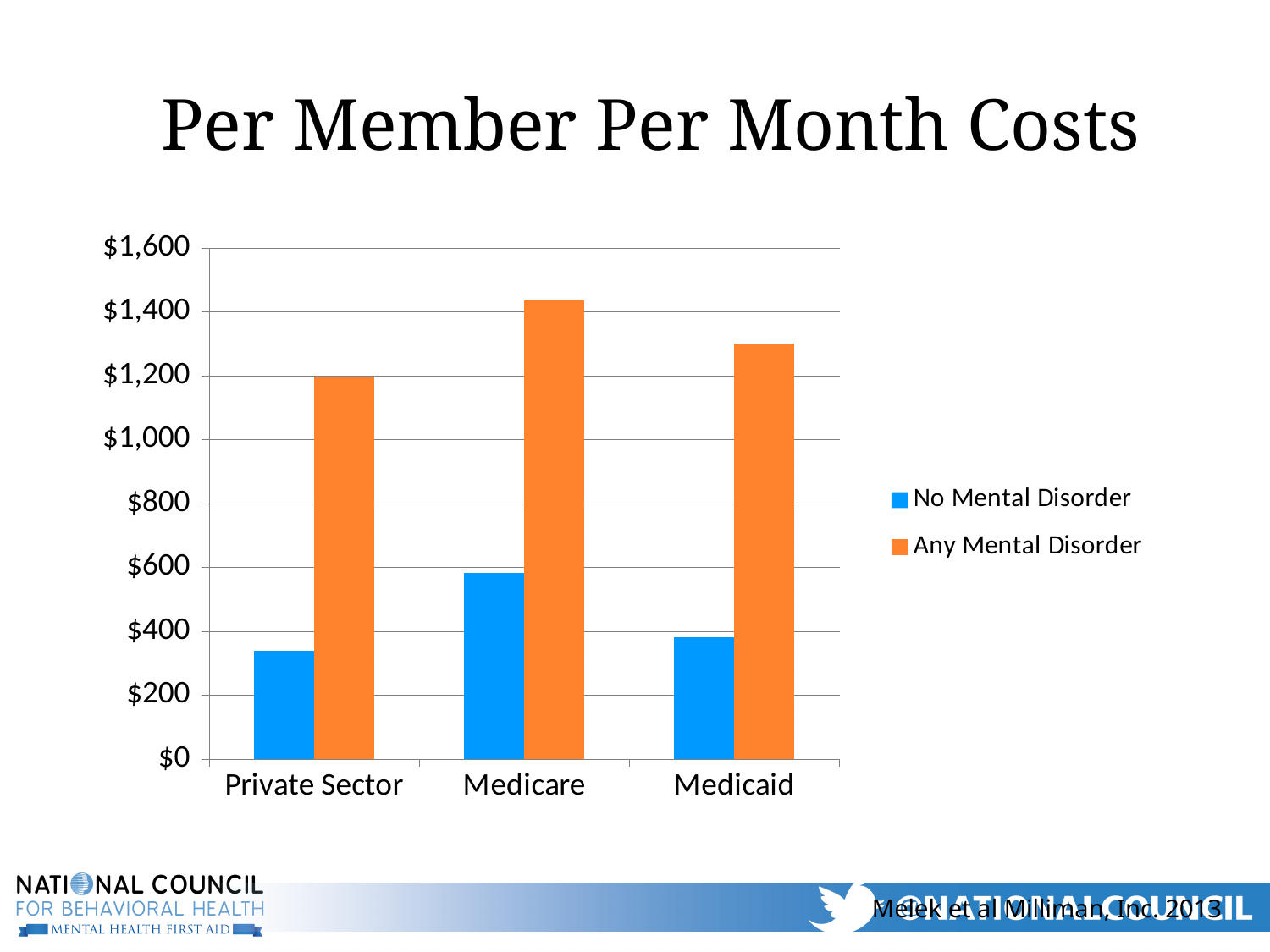
What is the title of the chart? Per Member Per Month Costs Is the No Mental Disorder value for Medicaid greater or less than $400? less Which category has the lowest Any Mental Disorder cost? Private Sector What kind of chart is shown on the slide? bar chart Which category has the highest Any Mental Disorder cost? Medicare Is the No Mental Disorder value for Medicare greater or less than $400? greater For Medicaid, which is larger: the No Mental Disorder cost or the Any Mental Disorder cost? Any Mental Disorder How many categories are shown on the x axis? 3 Which category has the highest No Mental Disorder cost? Medicare Is the Any Mental Disorder value for Medicare greater or less than $1,400? greater How many series does the legend list? 2 Which category has the lowest No Mental Disorder cost? Private Sector